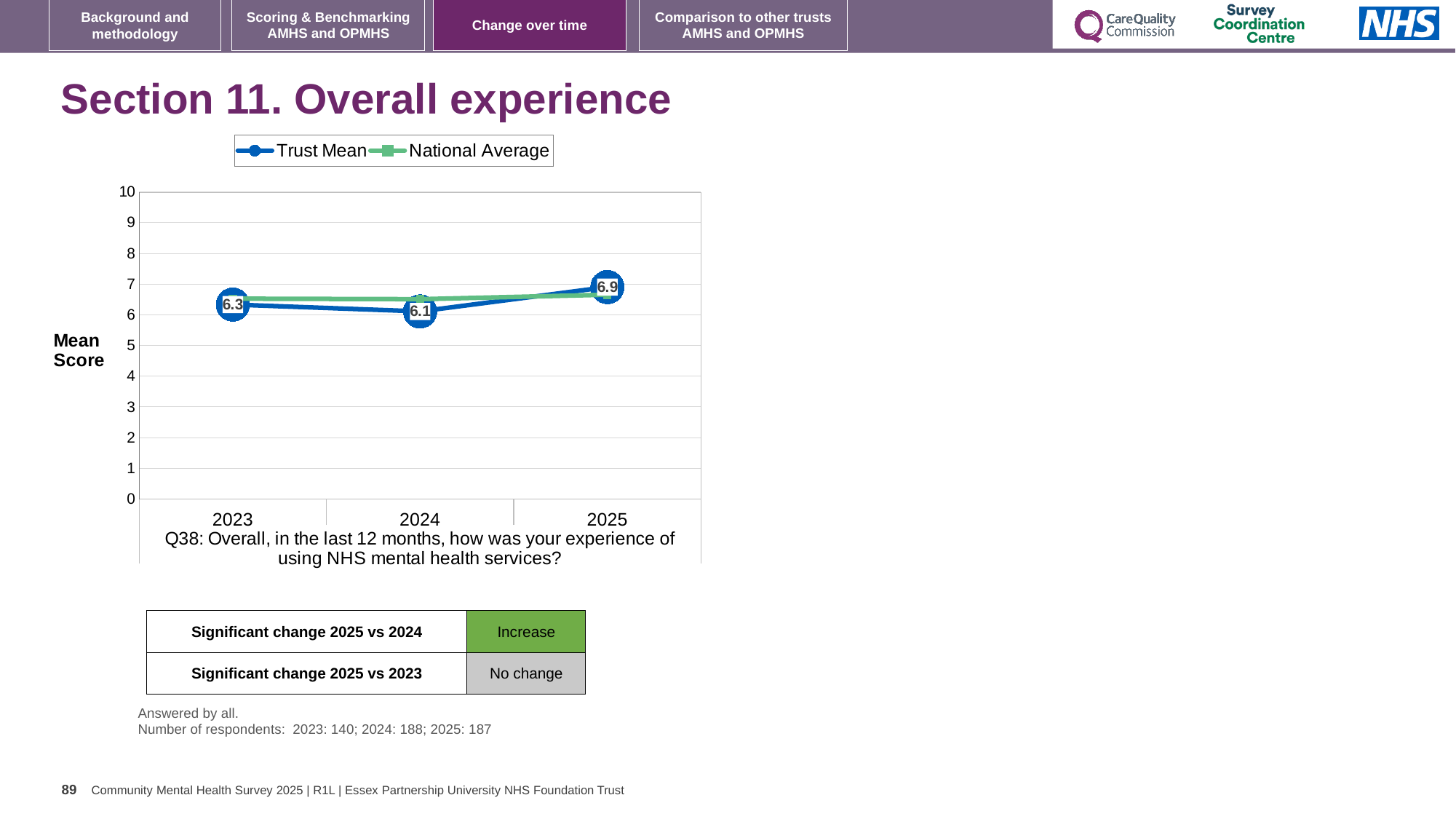
How many series does the chart legend list? 2 How many years are shown on the x axis of the chart? 3 Is the National Average value for 2023 greater or less than 5? greater What is the Trust Mean value for 2024? 6.1 What is the difference between the Trust Mean in 2025 and in 2024? 0.8 What kind of chart is shown on the slide? line chart In which year is the Trust Mean lowest? 2024 In which year is the Trust Mean highest? 2025 Which year has the larger Trust Mean, 2023 or 2024? 2023 What is the Trust Mean value for 2025? 6.9 Does the Trust Mean rise or fall from 2024 to 2025? rise What is the Trust Mean value for 2023? 6.3